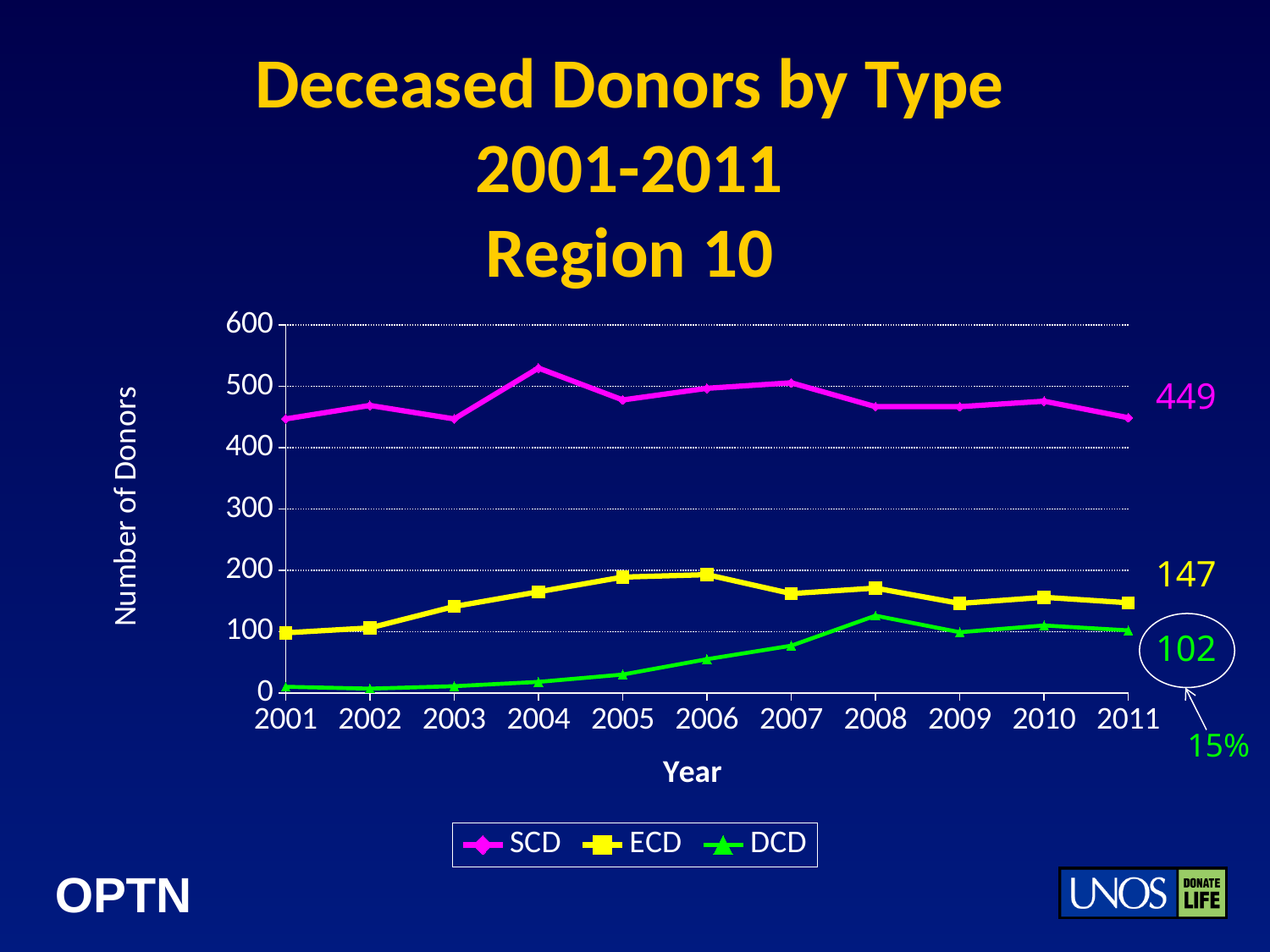
What is the value for SCD in 2011? 449 How many years are shown on the x axis? 11 Is the value for DCD in 2005 greater or less than 100? less In which year does the SCD series reach its highest value? 2004 Is the value for SCD in 2004 greater or less than 500? greater What is the difference between the ECD and DCD values in 2011? 45 What is the difference between the SCD and ECD values in 2011? 302 What is the value for ECD in 2011? 147 Which series has the highest values across all years? SCD What is the value for DCD in 2011? 102 How many series does the legend list? 3 What kind of chart is shown on the slide? Line chart